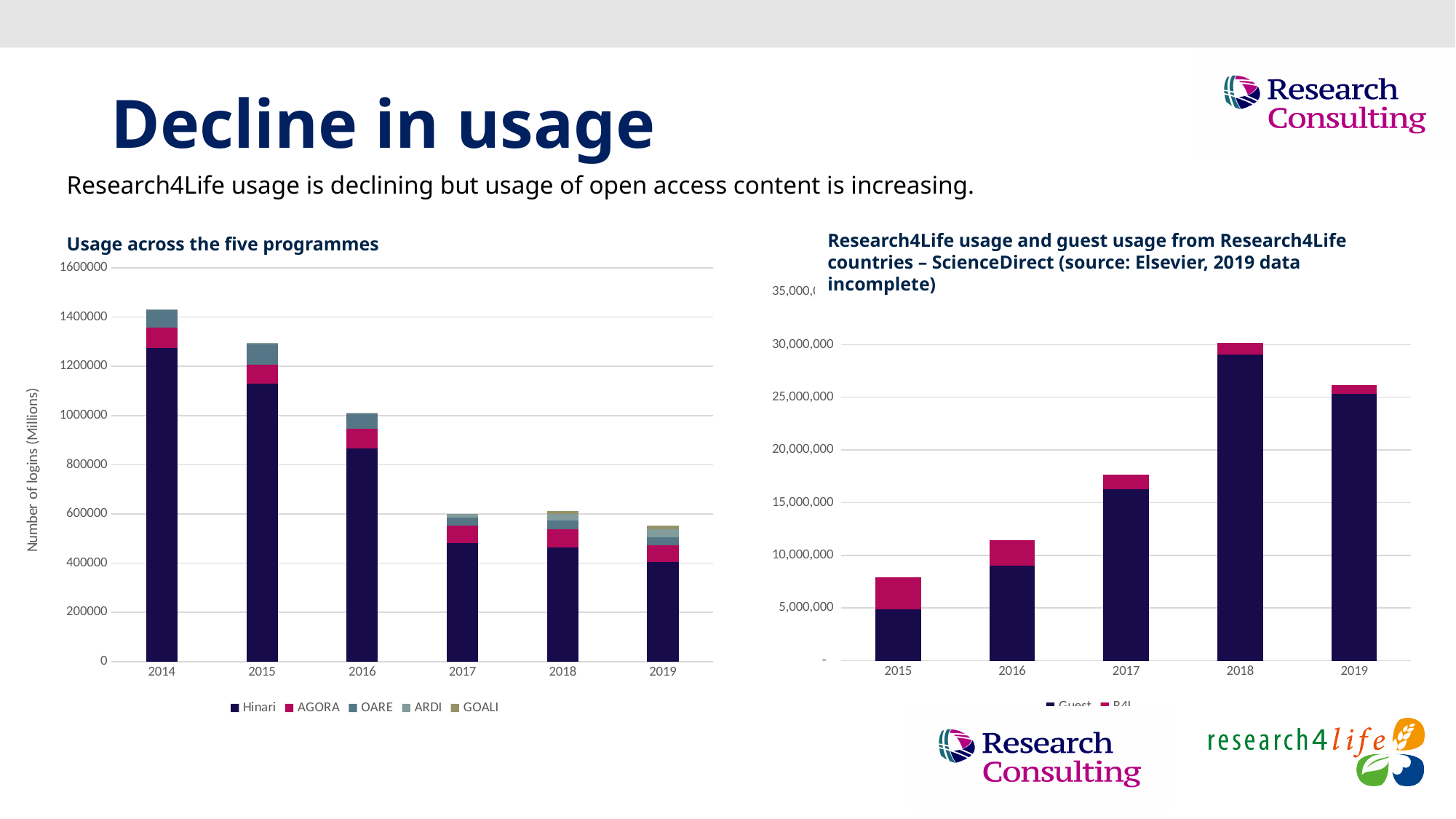
In the 'Usage across the five programmes' chart, is the total for 2017 greater or less than 800000? less In the right-hand chart (Research4Life usage and guest usage – ScienceDirect), which year has the lowest total? 2015 In the 'Usage across the five programmes' chart, which year has the highest total usage? 2014 In the 'Usage across the five programmes' chart, is the total for 2014 greater or less than 1400000? greater What kind of chart is the 'Usage across the five programmes' chart on the left? Stacked bar chart In the right-hand chart (Research4Life usage and guest usage – ScienceDirect), is the total for 2017 greater or less than 15,000,000? greater In the right-hand chart (Research4Life usage and guest usage – ScienceDirect), which year has the highest total? 2018 What is the y-axis label of the 'Usage across the five programmes' chart? Number of logins (Millions) How many series does the legend of the 'Usage across the five programmes' chart list? 5 How many years are shown on the x axis of the 'Usage across the five programmes' chart? 6 In the right-hand chart (Research4Life usage and guest usage – ScienceDirect), do the totals rise or fall from 2015 to 2018? rise In the 'Usage across the five programmes' chart, which year has the larger total, 2015 or 2016? 2015